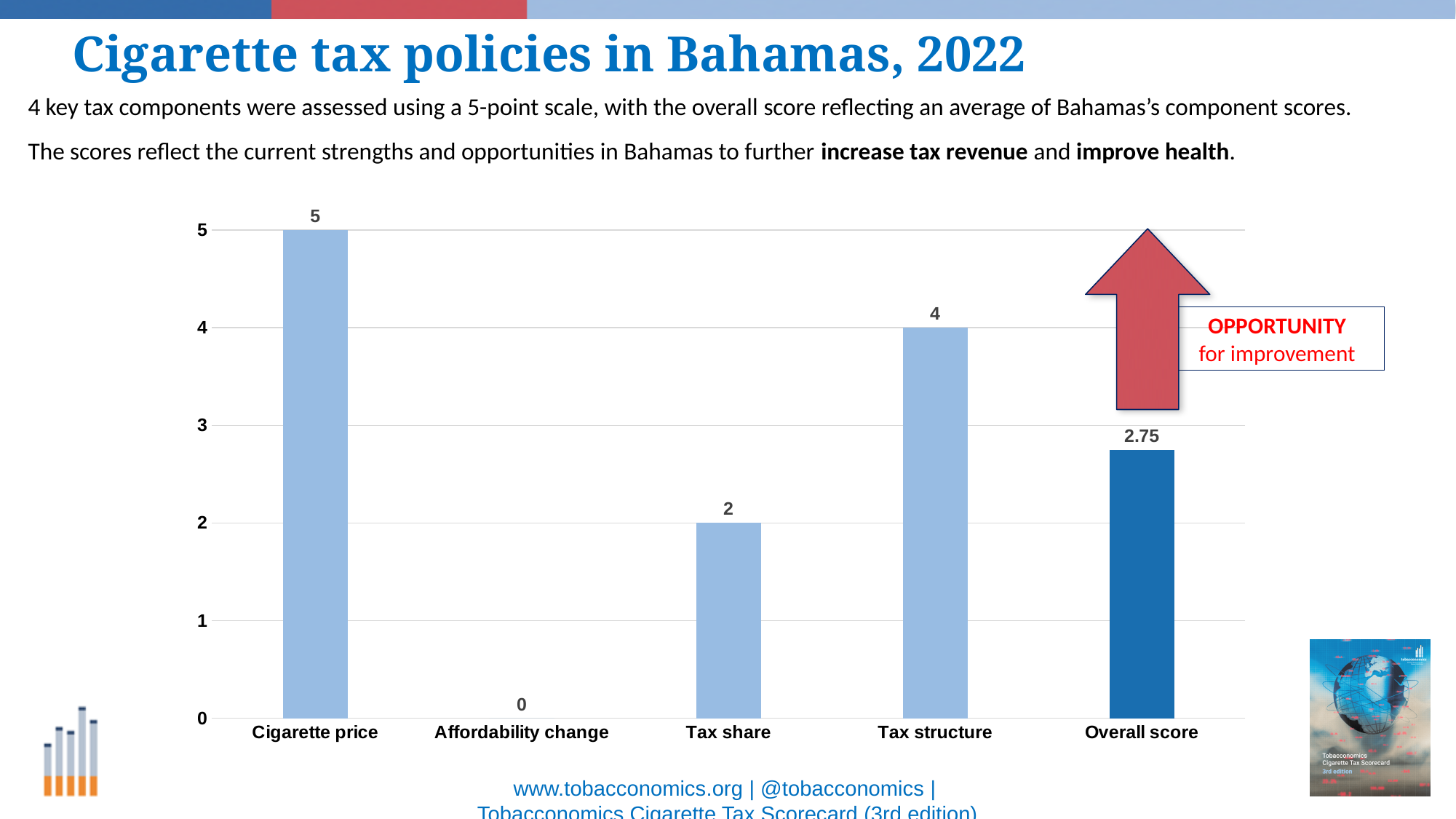
What is the Overall score? 2.75 Which category has the highest value? Cigarette price What is the value for Cigarette price? 5 Which is larger, the value for Tax share or the value for Tax structure? Tax structure What is the value for Tax share? 2 Which bar is shown in a darker blue than the others? Overall score What is the difference between the values for Cigarette price and Tax structure? 1 How many categories are shown on the x axis? 5 What is the value for Affordability change? 0 What kind of chart is shown on the slide? Bar chart What is the value for Tax structure? 4 Which category has the lowest value? Affordability change